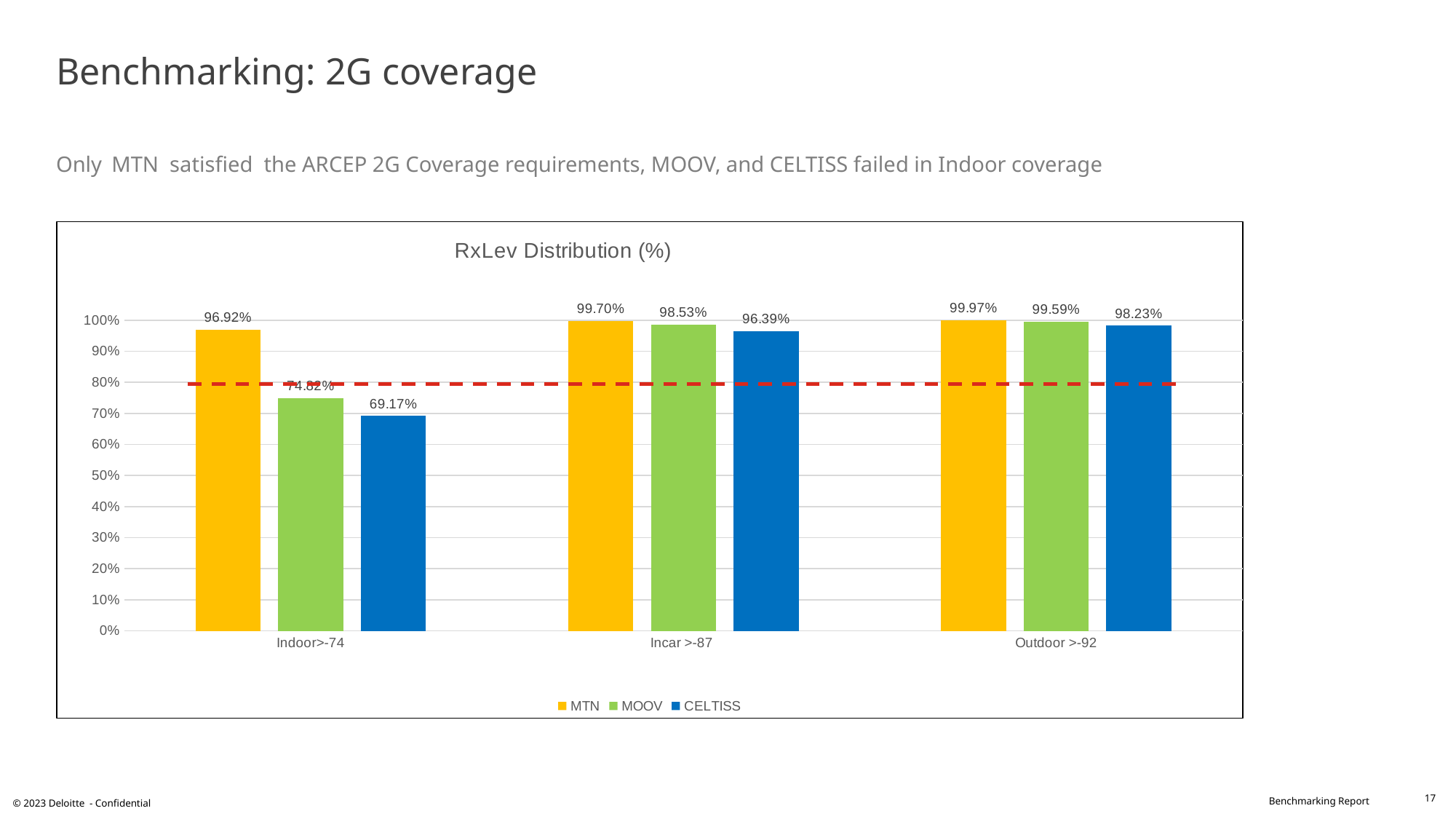
What is the difference between the MTN and CELTISS values in the Incar >-87 category? 3.31% What is the value for MTN in the Outdoor >-92 category? 99.97% What is the value for MTN in the Indoor>-74 category? 96.92% What is the value for MOOV in the Incar >-87 category? 98.53% Which is larger: the CELTISS value for Incar >-87 or the CELTISS value for Outdoor >-92? Outdoor >-92 Which series has the highest value in the Outdoor >-92 category? MTN What is the value for CELTISS in the Indoor>-74 category? 69.17% What is the title of the chart? RxLev Distribution (%) How many categories are shown on the x axis? 3 Is the value for MOOV in the Indoor>-74 category greater or less than 80%? less How many series does the legend list? 3 Which series has the lowest value in the Indoor>-74 category? CELTISS